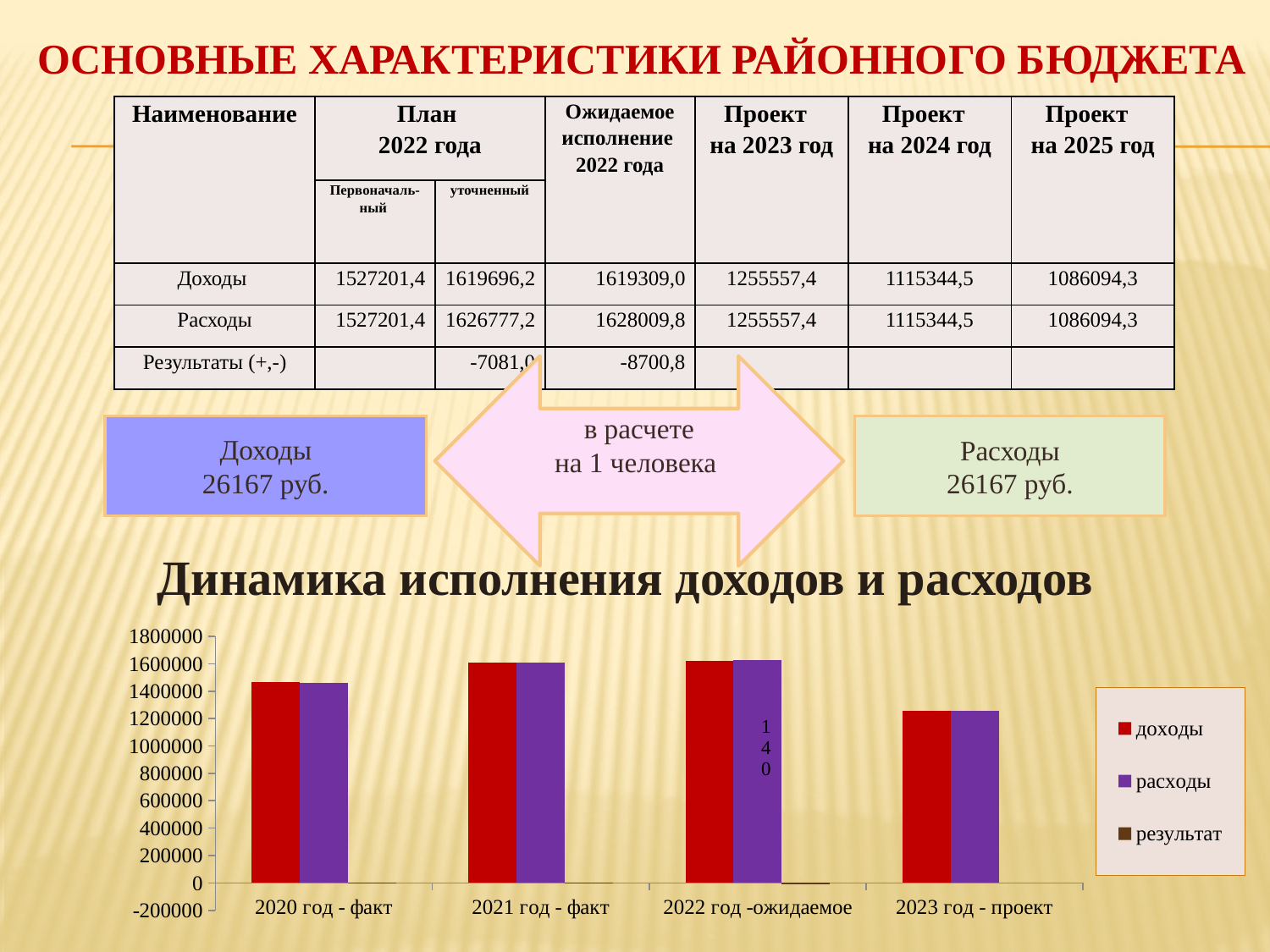
In the chart 'Динамика исполнения доходов и расходов', which category has the lowest доходы value? 2023 год - проект In the chart 'Динамика исполнения доходов и расходов', which category has the lowest расходы value? 2023 год - проект How many series does the legend of the chart 'Динамика исполнения доходов и расходов' list? 3 In the chart 'Динамика исполнения доходов и расходов', is the доходы value for 2023 год - проект greater or less than 1400000? less What is the title of the bar chart at the bottom of the slide? Динамика исполнения доходов и расходов How many categories are shown on the x axis of the chart 'Динамика исполнения доходов и расходов'? 4 In the chart 'Динамика исполнения доходов и расходов', is the расходы value for 2021 год - факт greater or less than 1400000? greater In the chart 'Динамика исполнения доходов и расходов', is the доходы value for 2020 год - факт greater or less than 1200000? greater In the chart 'Динамика исполнения доходов и расходов', what colour represents the доходы series? red In the chart 'Динамика исполнения доходов и расходов', which is larger: the доходы value for 2020 год - факт or for 2023 год - проект? 2020 год - факт In the chart 'Динамика исполнения доходов и расходов', do the расходы values rise or fall from 2022 год -ожидаемое to 2023 год - проект? fall What kind of chart is shown under the heading 'Динамика исполнения доходов и расходов'? bar chart